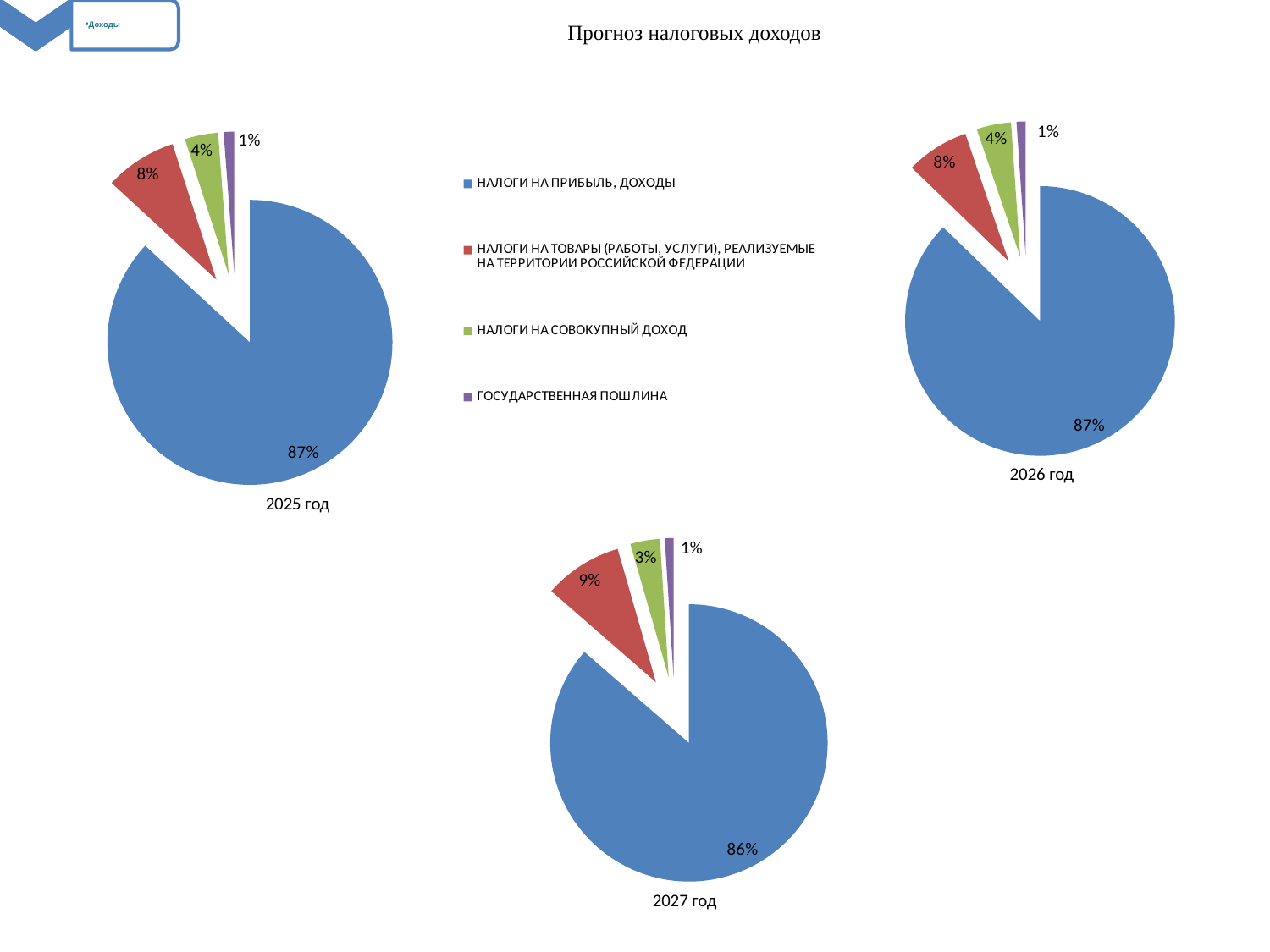
In the 2027 год pie chart, what is the difference between the share for НАЛОГИ НА ПРИБЫЛЬ, ДОХОДЫ and the share for НАЛОГИ НА ТОВАРЫ (РАБОТЫ, УСЛУГИ), РЕАЛИЗУЕМЫЕ НА ТЕРРИТОРИИ РОССИЙСКОЙ ФЕДЕРАЦИИ? 77% In the 2026 год pie chart, which category has the smallest share? ГОСУДАРСТВЕННАЯ ПОШЛИНА In the 2027 год pie chart, what share is shown for НАЛОГИ НА ТОВАРЫ (РАБОТЫ, УСЛУГИ), РЕАЛИЗУЕМЫЕ НА ТЕРРИТОРИИ РОССИЙСКОЙ ФЕДЕРАЦИИ? 9% What kind of chart is the 2027 год chart? Pie chart How many entries does the legend list? 4 In the 2025 год pie chart, which is larger: the share for НАЛОГИ НА ТОВАРЫ (РАБОТЫ, УСЛУГИ), РЕАЛИЗУЕМЫЕ НА ТЕРРИТОРИИ РОССИЙСКОЙ ФЕДЕРАЦИИ or the share for НАЛОГИ НА СОВОКУПНЫЙ ДОХОД? НАЛОГИ НА ТОВАРЫ (РАБОТЫ, УСЛУГИ), РЕАЛИЗУЕМЫЕ НА ТЕРРИТОРИИ РОССИЙСКОЙ ФЕДЕРАЦИИ In the 2027 год pie chart, what share is shown for ГОСУДАРСТВЕННАЯ ПОШЛИНА? 1% In the 2025 год pie chart, which category has the largest share? НАЛОГИ НА ПРИБЫЛЬ, ДОХОДЫ How many pie charts are shown on the slide? 3 How many slices does the 2026 год pie chart have? 4 In the 2025 год pie chart, what share is shown for НАЛОГИ НА ПРИБЫЛЬ, ДОХОДЫ? 87% In the 2026 год pie chart, what share is shown for НАЛОГИ НА СОВОКУПНЫЙ ДОХОД? 4%